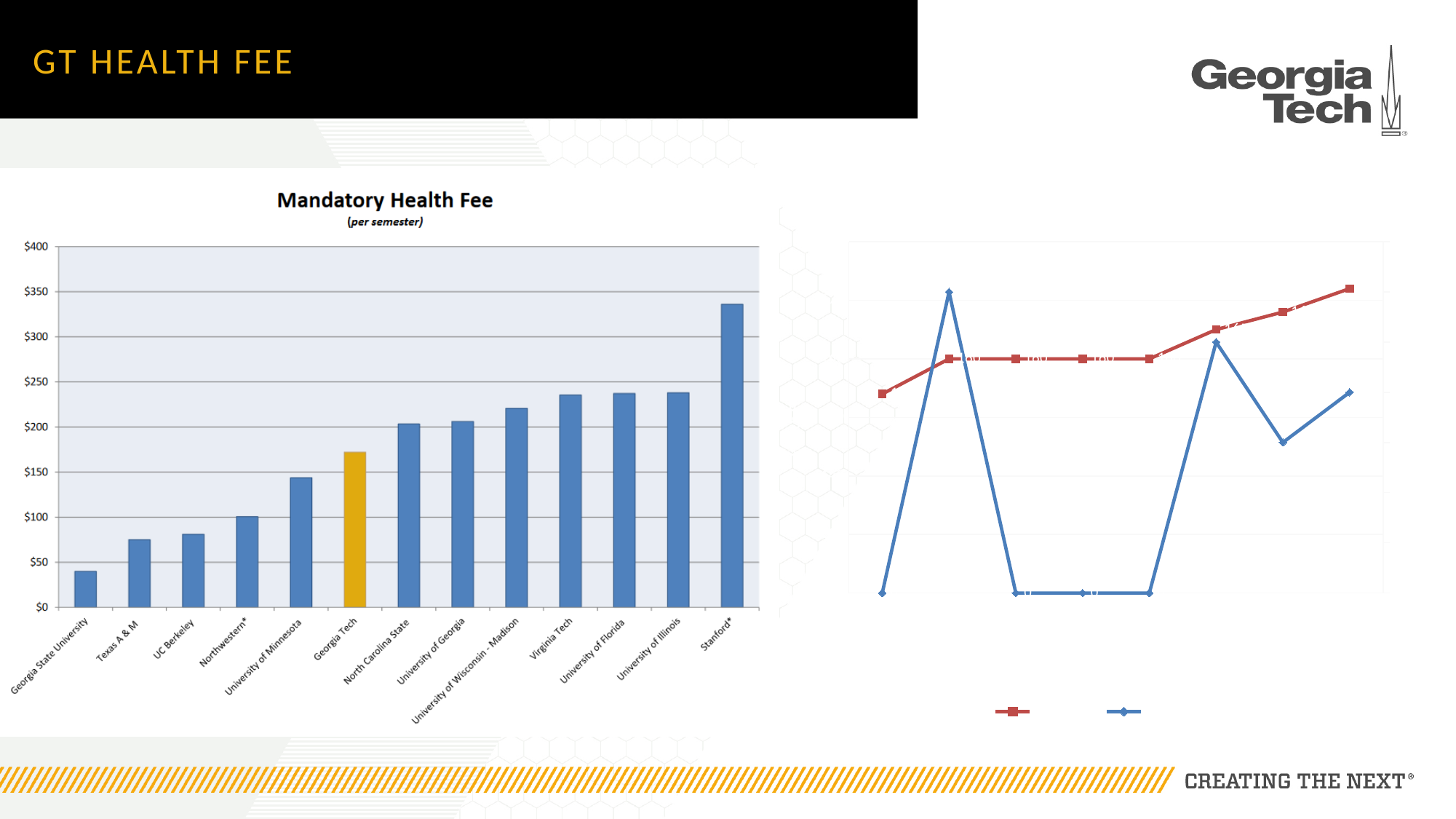
On the 'Mandatory Health Fee' chart, is the value for Stanford* greater or less than $300? greater On the 'Mandatory Health Fee' chart, is the value for Georgia Tech greater or less than $150? greater How many universities are shown on the 'Mandatory Health Fee' bar chart? 13 What kind of chart is the 'Mandatory Health Fee' chart on the left of the slide? bar chart On the 'Mandatory Health Fee' chart, is the value for Northwestern* greater or less than $150? less On the 'Mandatory Health Fee' chart, do the bar values rise or fall from left to right? rise On the 'Mandatory Health Fee' chart, which university's bar is highlighted in gold instead of blue? Georgia Tech On the 'Mandatory Health Fee' chart, which university has the lowest fee? Georgia State University What kind of chart is shown on the right side of the slide? line chart On the 'Mandatory Health Fee' chart, which university has the highest fee? Stanford* On the 'Mandatory Health Fee' chart, which has the larger fee, Georgia Tech or North Carolina State? North Carolina State